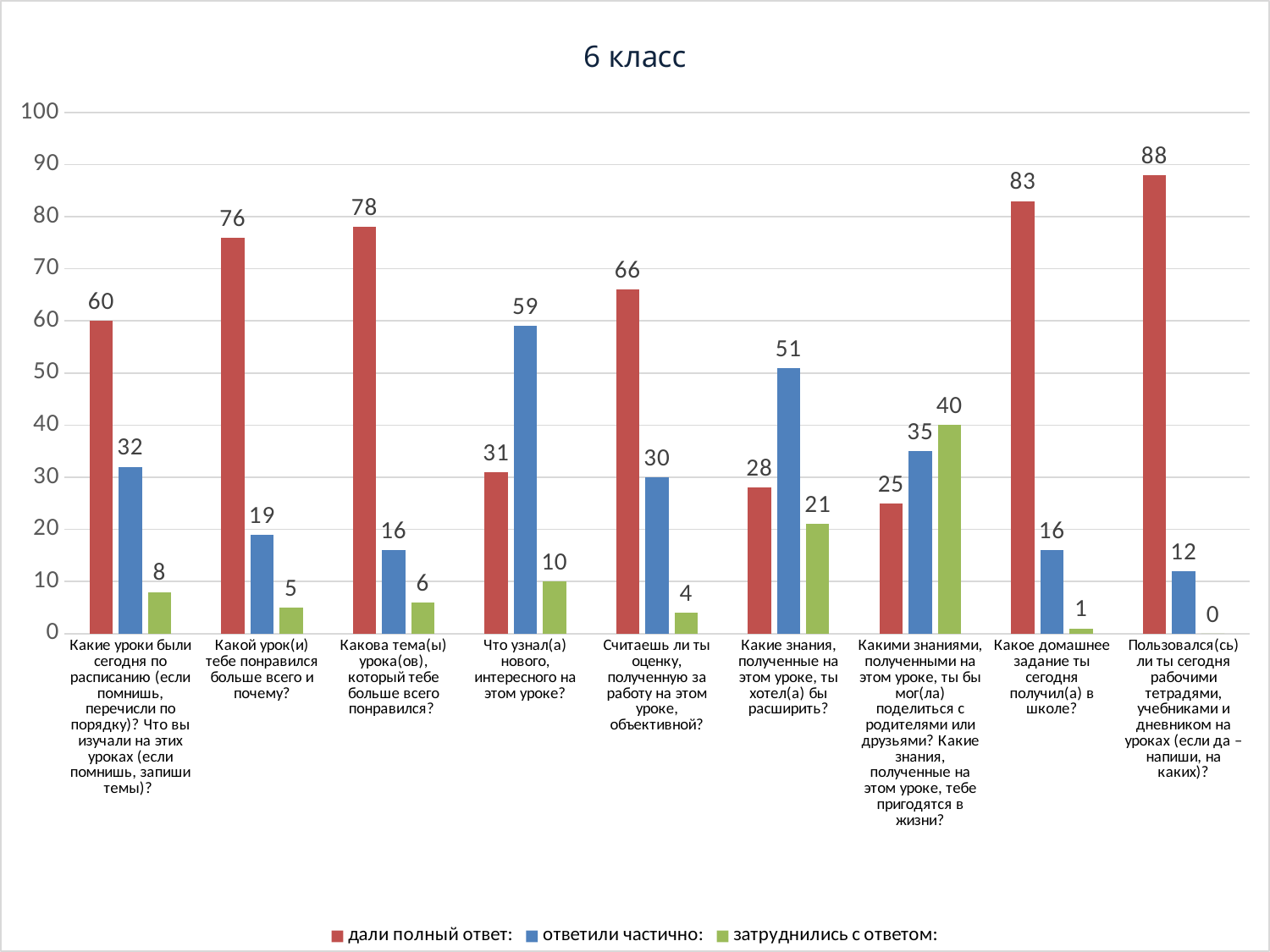
Which category has the lowest value for 'затруднились с ответом'? Пользовался(сь) ли ты сегодня рабочими тетрадями, учебниками и дневником на уроках (если да – напиши, на каких)? Which category has the highest value for 'дали полный ответ'? Пользовался(сь) ли ты сегодня рабочими тетрадями, учебниками и дневником на уроках (если да – напиши, на каких)? Is the value of 'дали полный ответ' for 'Считаешь ли ты оценку, полученную за работу на этом уроке, объективной?' greater or less than 60? greater How many question categories are shown on the x axis? 9 What is the value of 'ответили частично' for 'Что узнал(а) нового, интересного на этом уроке?'? 59 What is the difference between 'дали полный ответ' and 'ответили частично' for 'Какие уроки были сегодня по расписанию...'? 28 What is the title of the chart? 6 класс What type of chart is shown on the slide? bar chart What is the value of 'затруднились с ответом' for 'Какими знаниями, полученными на этом уроке, ты бы мог(ла) поделиться с родителями или друзьями?...'? 40 For 'Какие знания, полученные на этом уроке, ты хотел(а) бы расширить?', which is larger: 'дали полный ответ' or 'ответили частично'? ответили частично How many series does the legend list? 3 What is the value of 'дали полный ответ' for 'Какое домашнее задание ты сегодня получил(а) в школе?'? 83